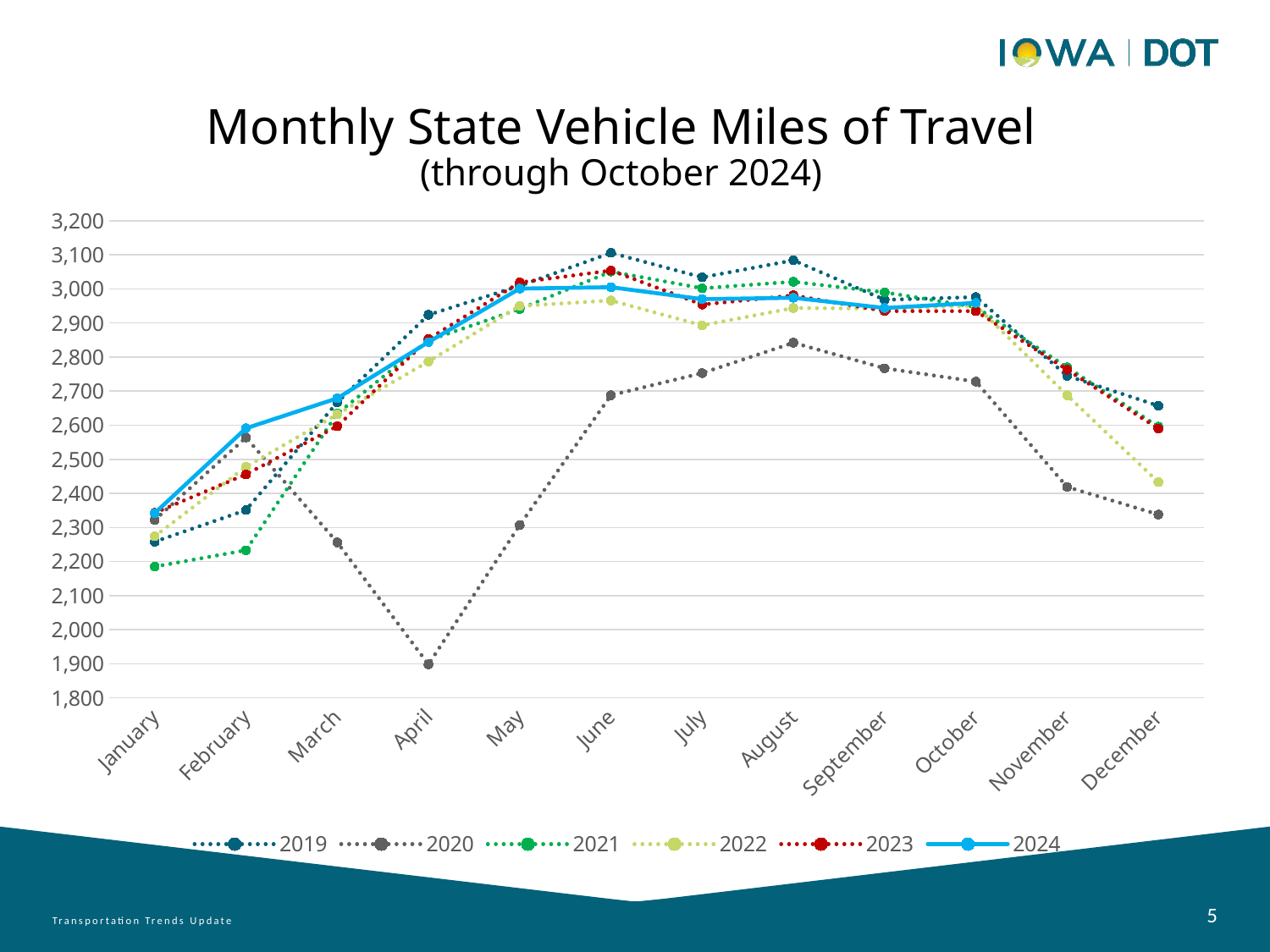
Which year's line has the lowest value in April? 2020 Is the 2020 value for April greater or less than 2,000? less Is the 2019 value for June greater or less than 3,000? greater Does the 2024 line rise or fall from January to May? rise Which is larger in December, the 2020 value or the 2022 value? 2022 Which year's line has the highest value in June? 2019 How many months are shown along the x axis? 12 What kind of chart is shown on the slide? line chart How many series does the legend list? 6 Does the 2020 line rise or fall from February to April? fall Is the 2024 value for February greater or less than 2,500? greater Which year is drawn as a solid line rather than a dotted line? 2024